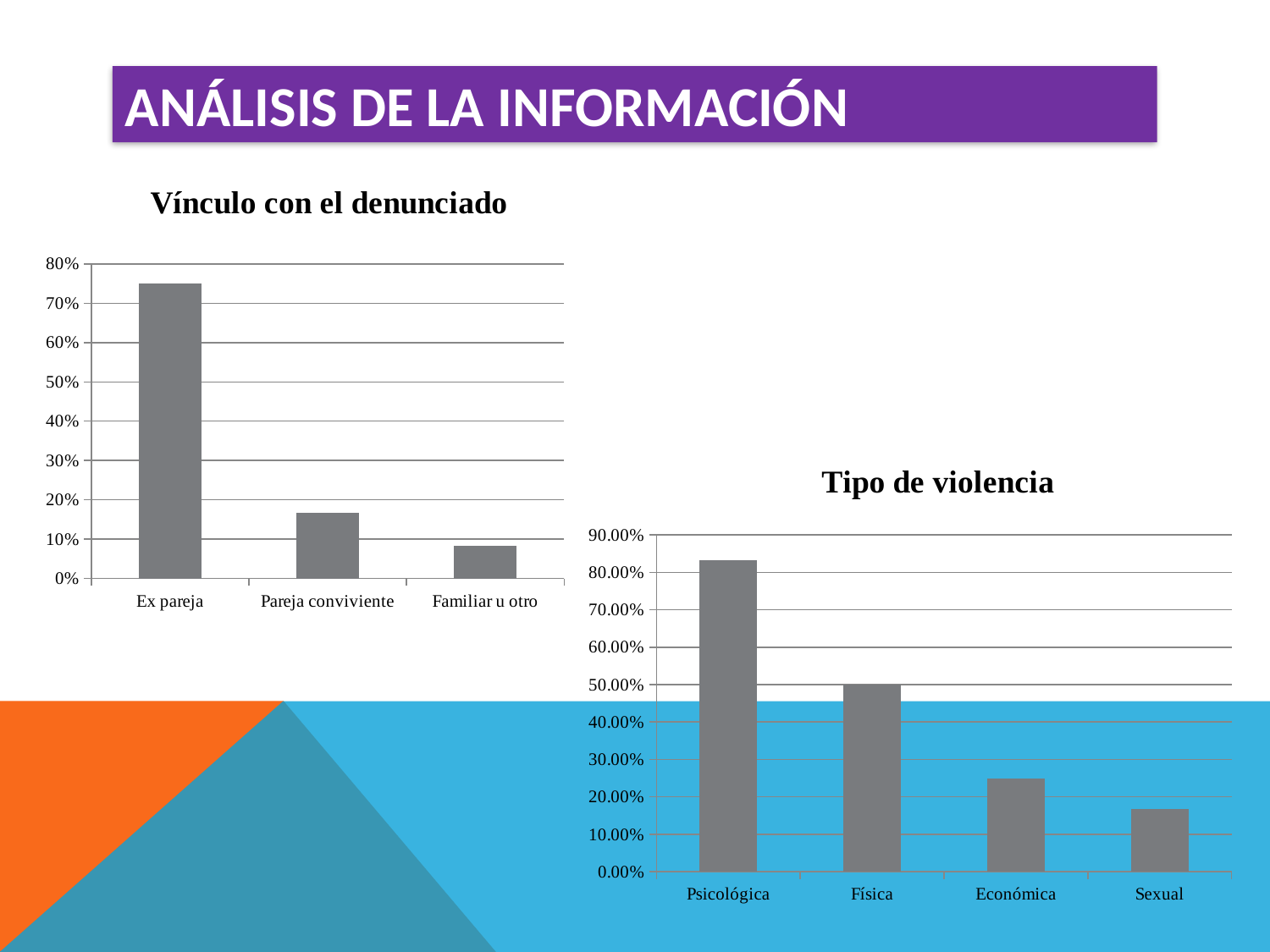
In the 'Tipo de violencia' chart, which category has the highest value? Psicológica In the 'Tipo de violencia' chart, which is larger, Física or Económica? Física In the 'Tipo de violencia' chart, is the value for Económica greater or less than 30.00%? less How many categories are shown in the 'Vínculo con el denunciado' chart? 3 In the 'Vínculo con el denunciado' chart, which category has the lowest value? Familiar u otro In the 'Tipo de violencia' chart, is the value for Psicológica greater or less than 80.00%? greater How many categories are shown in the 'Tipo de violencia' chart? 4 In the 'Vínculo con el denunciado' chart, which category has the highest value? Ex pareja In the 'Vínculo con el denunciado' chart, is the value for Ex pareja greater or less than 70%? greater In the 'Tipo de violencia' chart, which category has the lowest value? Sexual What type of chart is 'Vínculo con el denunciado'? Bar chart